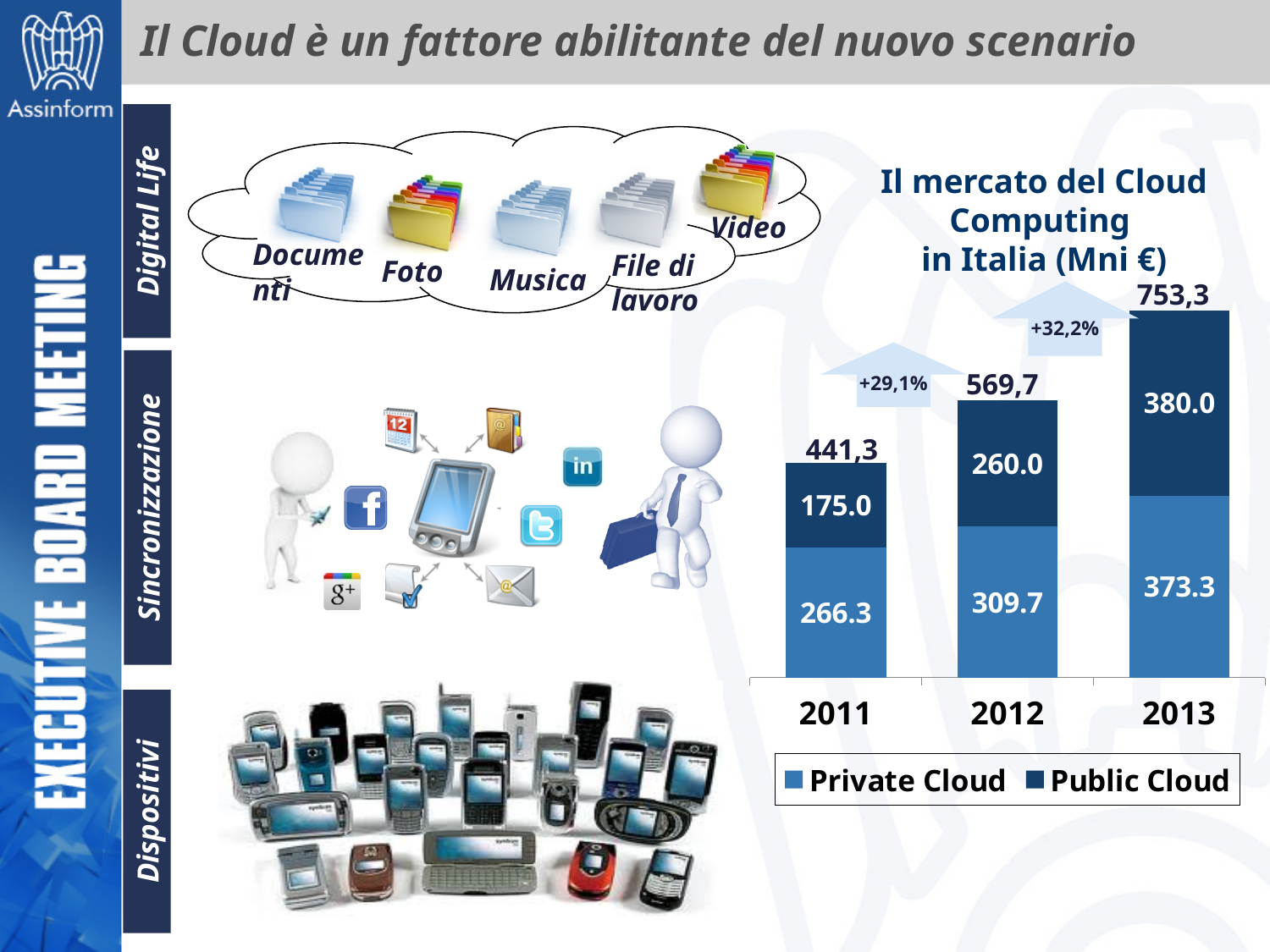
What is the Public Cloud value for 2012? 260.0 What is the difference between the Private Cloud values for 2013 and 2012? 63.6 What is the total of the stacked bar for 2012? 569,7 Which is larger in 2011, Private Cloud or Public Cloud? Private Cloud How many years are shown on the x axis? 3 Which year has the lowest Public Cloud value? 2011 How many series does the legend list? 2 What is the Public Cloud value for 2013? 380.0 What is the Private Cloud value for 2011? 266.3 What kind of chart is shown? Stacked bar chart What is the growth percentage shown between 2012 and 2013? +32,2% Which year has the highest total value? 2013